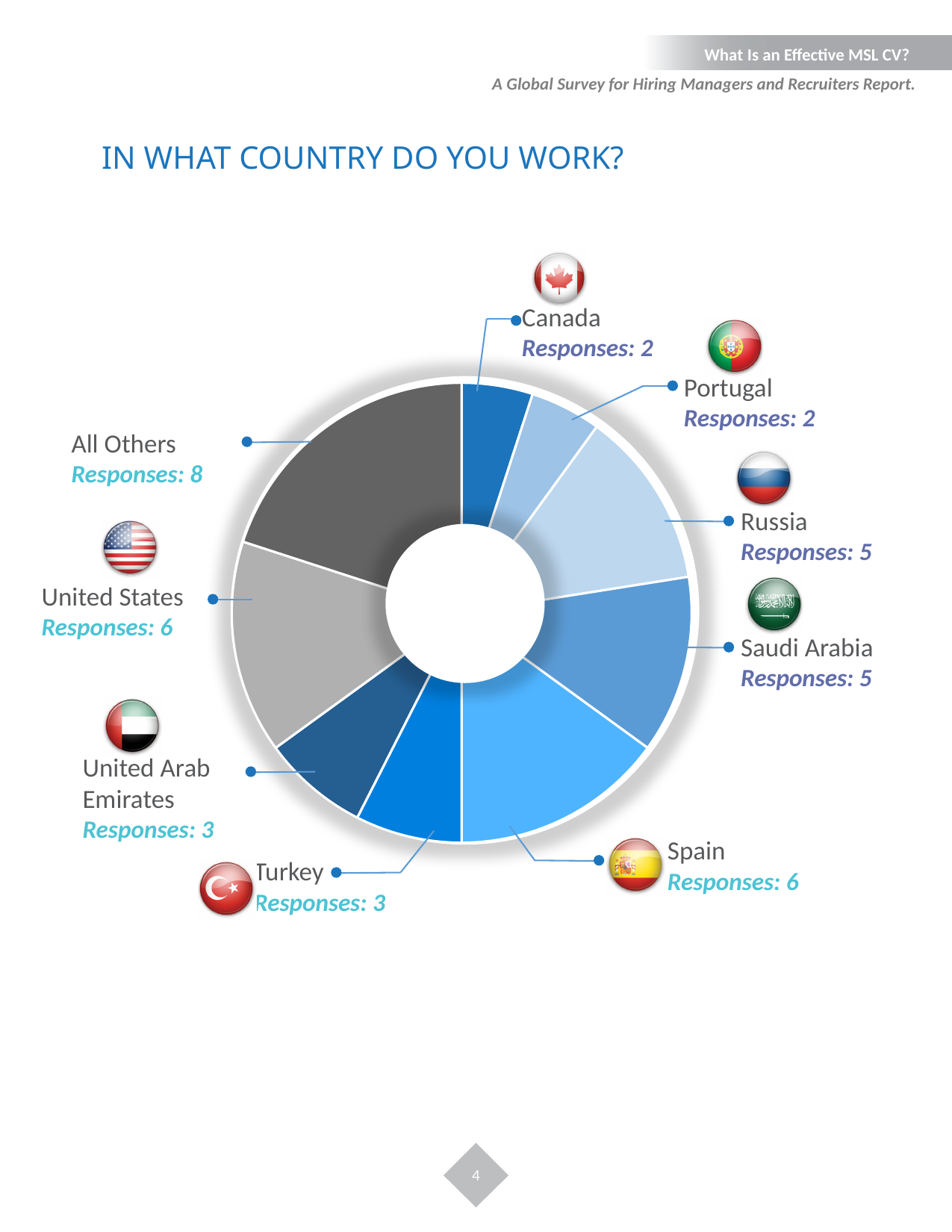
Which category has the highest number of responses? All Others What share of all responses does All Others represent? 20% What is the title of the chart? IN WHAT COUNTRY DO YOU WORK? What is the total number of responses across all categories in the chart? 40 How many responses are shown for Canada? 2 What kind of chart is shown on the slide? Pie chart (donut) What is the difference in responses between All Others and the United States? 2 How many responses are shown for the United Arab Emirates? 3 How many responses are shown for Russia? 5 How many categories are shown in the chart? 9 How many responses are shown for Spain? 6 Which has more responses, Saudi Arabia or Turkey? Saudi Arabia